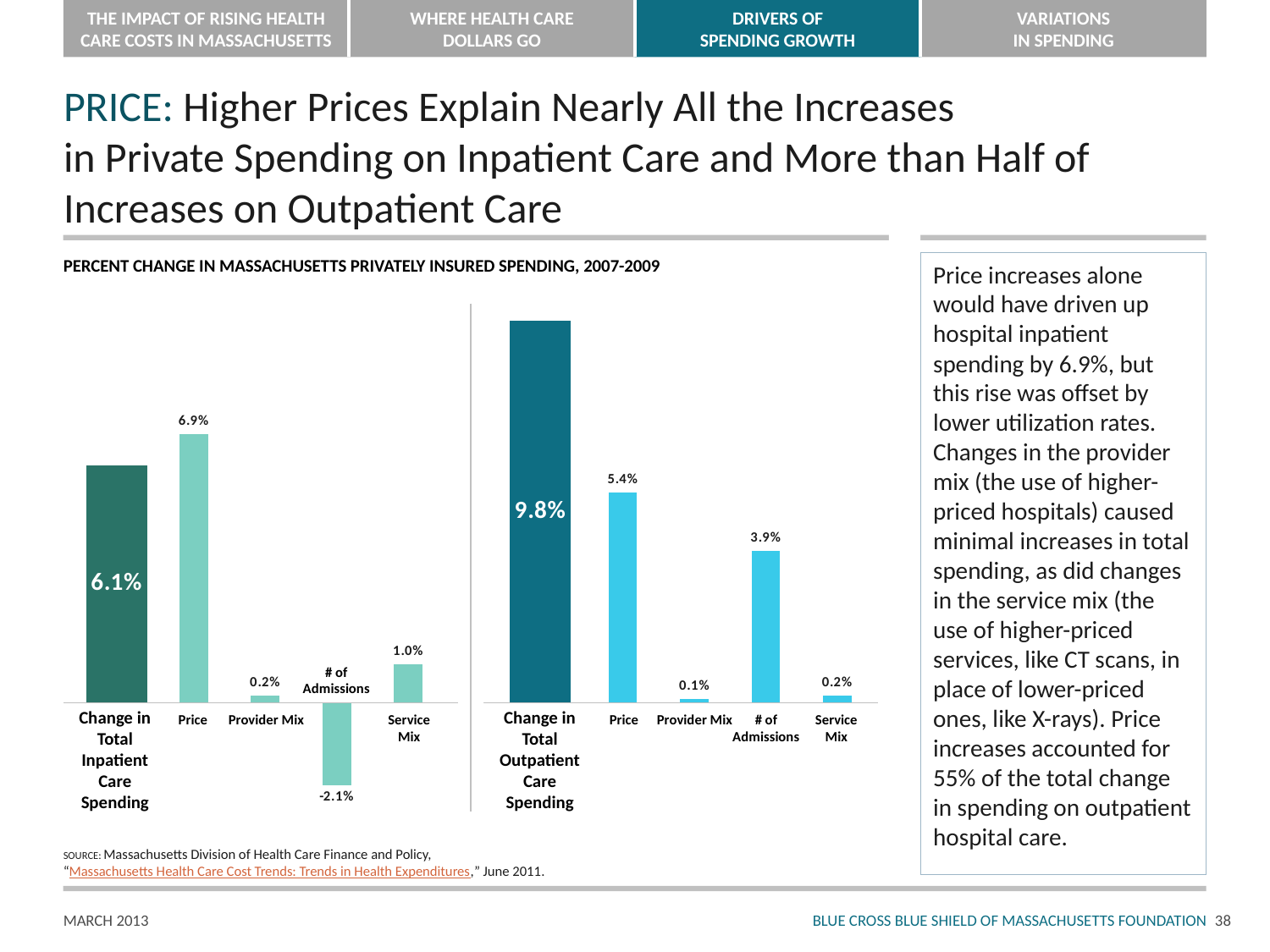
In the left (inpatient) chart, what is the value for # of Admissions? -2.1% Which is larger: Price in the left (inpatient) chart or Price in the right (outpatient) chart? Price in the left (inpatient) chart In the left (inpatient) chart, what is the difference between Price and Change in Total Inpatient Care Spending? 0.8% In the right (outpatient) chart, which category has the lowest value? Provider Mix In the right (outpatient) chart, what is the difference between Price and # of Admissions? 1.5% In the left (inpatient) chart, what is the value for Price? 6.9% In the right (outpatient) chart, what is the value for # of Admissions? 3.9% In the left (inpatient) chart, which category has the highest value? Price What type of chart is used on this slide? Bar chart How many bars are in the right (outpatient) chart? 5 In the left (inpatient) chart, which category has the lowest value? # of Admissions In the right (outpatient) chart, what is the value for Change in Total Outpatient Care Spending? 9.8%